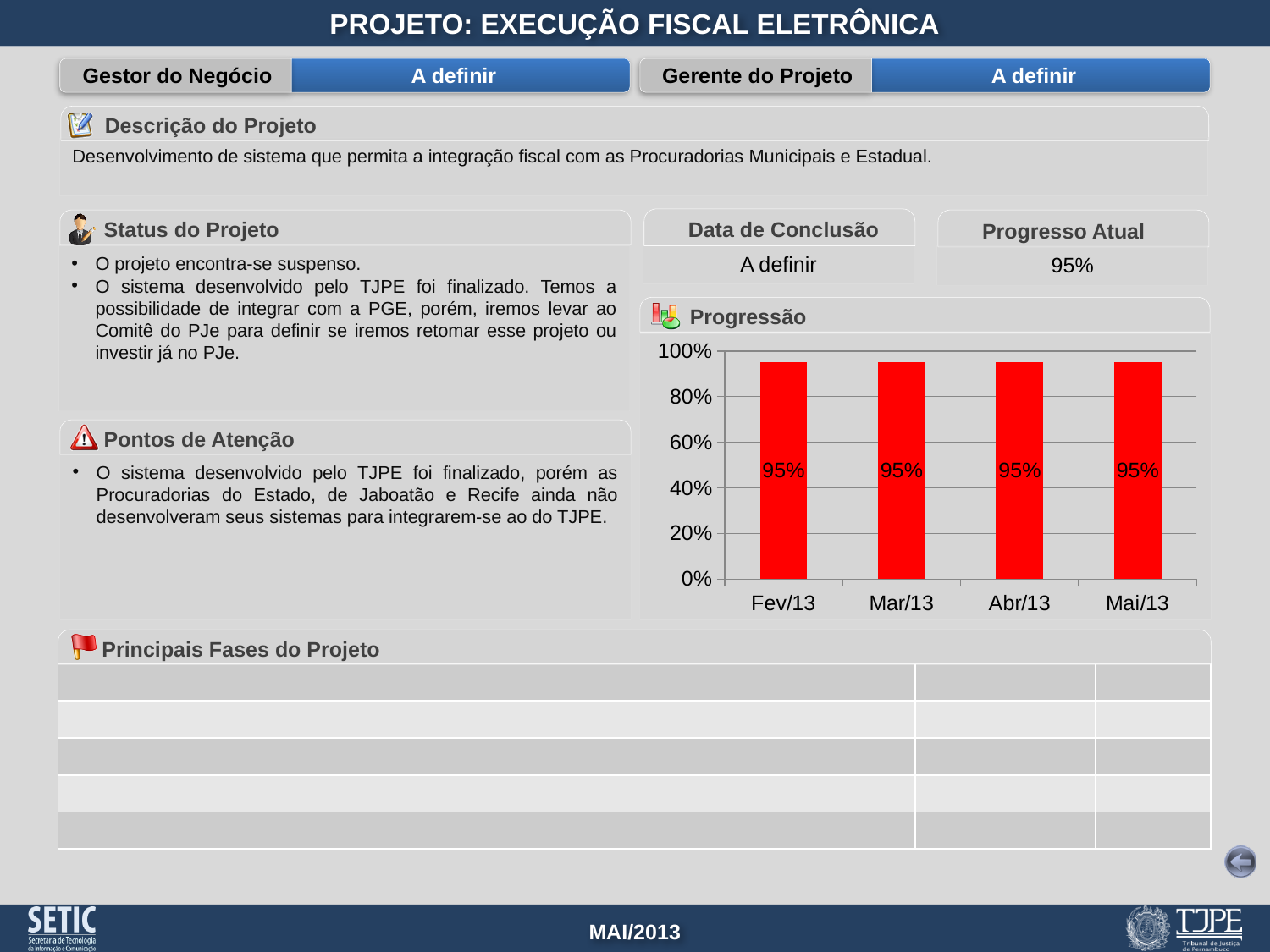
What is the difference between the values for Fev/13 and Mai/13 in the Progressão chart? 0% Is the value for Mar/13 in the Progressão chart greater or less than 100%? less How many categories are shown on the x axis of the Progressão chart? 4 What colour are the bars in the Progressão chart? red What is the value for Fev/13 in the Progressão chart? 95% What is the value for Mar/13 in the Progressão chart? 95% What kind of chart is the Progressão chart? bar chart Do the values in the Progressão chart rise, fall, or stay the same from Fev/13 to Mai/13? stay the same What is the title of the chart on the slide? Progressão What is the value for Abr/13 in the Progressão chart? 95% What is the value for Mai/13 in the Progressão chart? 95% Is the value for Abr/13 in the Progressão chart greater or less than 80%? greater